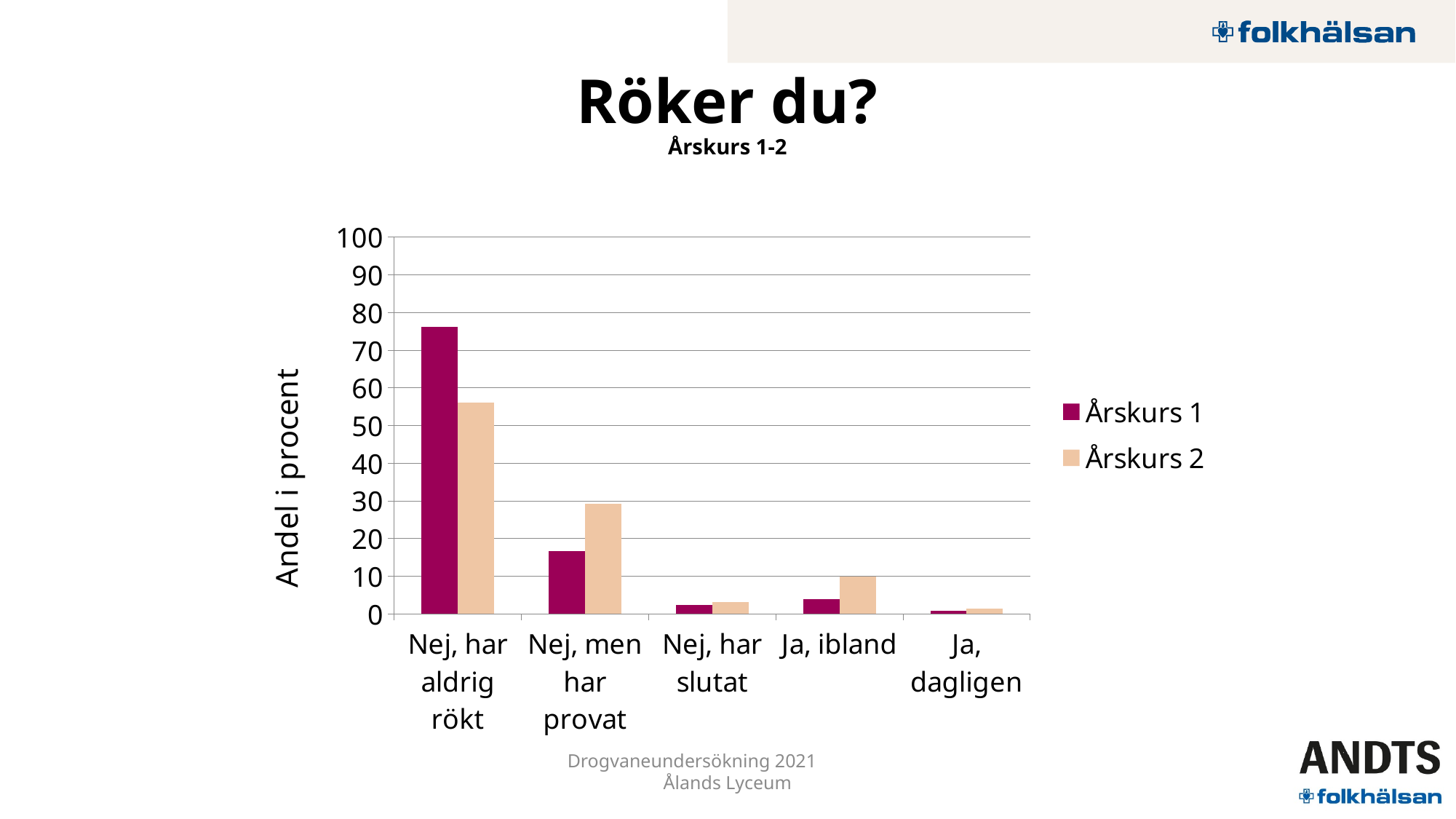
Is the value for Årskurs 1 in 'Nej, har aldrig rökt' greater or less than 70? greater For 'Nej, har aldrig rökt', which series has the larger value, Årskurs 1 or Årskurs 2? Årskurs 1 Is the value for Årskurs 2 in 'Nej, men har provat' greater or less than 20? greater How many series does the legend list? 2 How many response categories are shown on the x axis? 5 Is the value for Årskurs 2 in 'Nej, har aldrig rökt' greater or less than 60? less For 'Nej, men har provat', which series has the larger value, Årskurs 1 or Årskurs 2? Årskurs 2 Which category has the lowest value for Årskurs 2? Ja, dagligen Which category has the highest value for Årskurs 1? Nej, har aldrig rökt What kind of chart is shown on the slide? bar chart What is the label of the vertical axis? Andel i procent